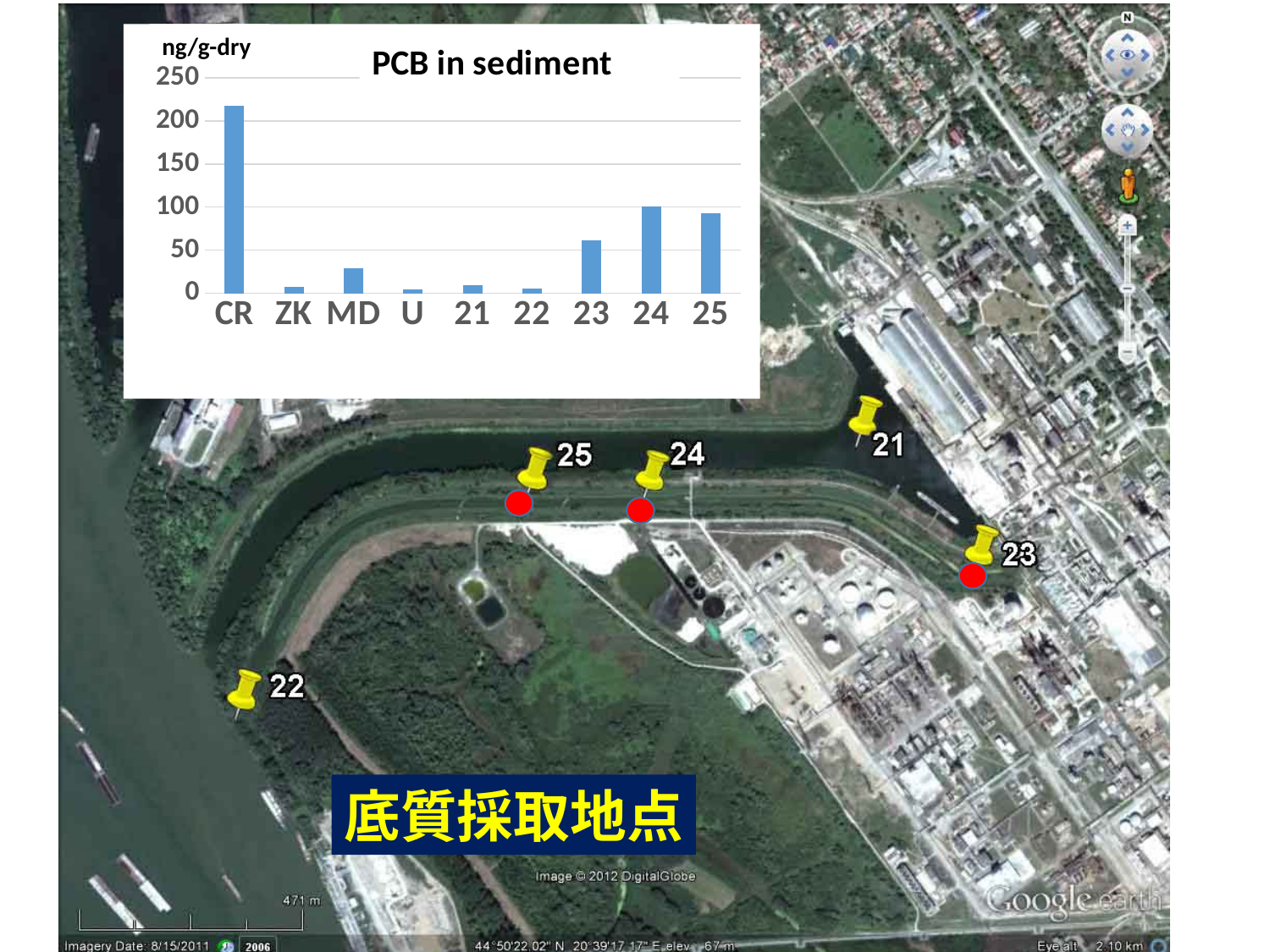
In the 'PCB in sediment' chart, which is larger, the value for MD or the value for ZK? MD What kind of chart is the 'PCB in sediment' chart? bar chart How many categories are shown on the x axis of the 'PCB in sediment' chart? 9 Is the value for 22 in the 'PCB in sediment' chart greater or less than 50? less Which category has the highest value in the 'PCB in sediment' chart? CR What is the title of the chart on the slide? PCB in sediment Is the value for 23 in the 'PCB in sediment' chart greater or less than 50? greater In the 'PCB in sediment' chart, which is larger, the value for 24 or the value for 23? 24 Is the value for 25 in the 'PCB in sediment' chart greater or less than 100? less What unit is shown on the y axis of the 'PCB in sediment' chart? ng/g-dry